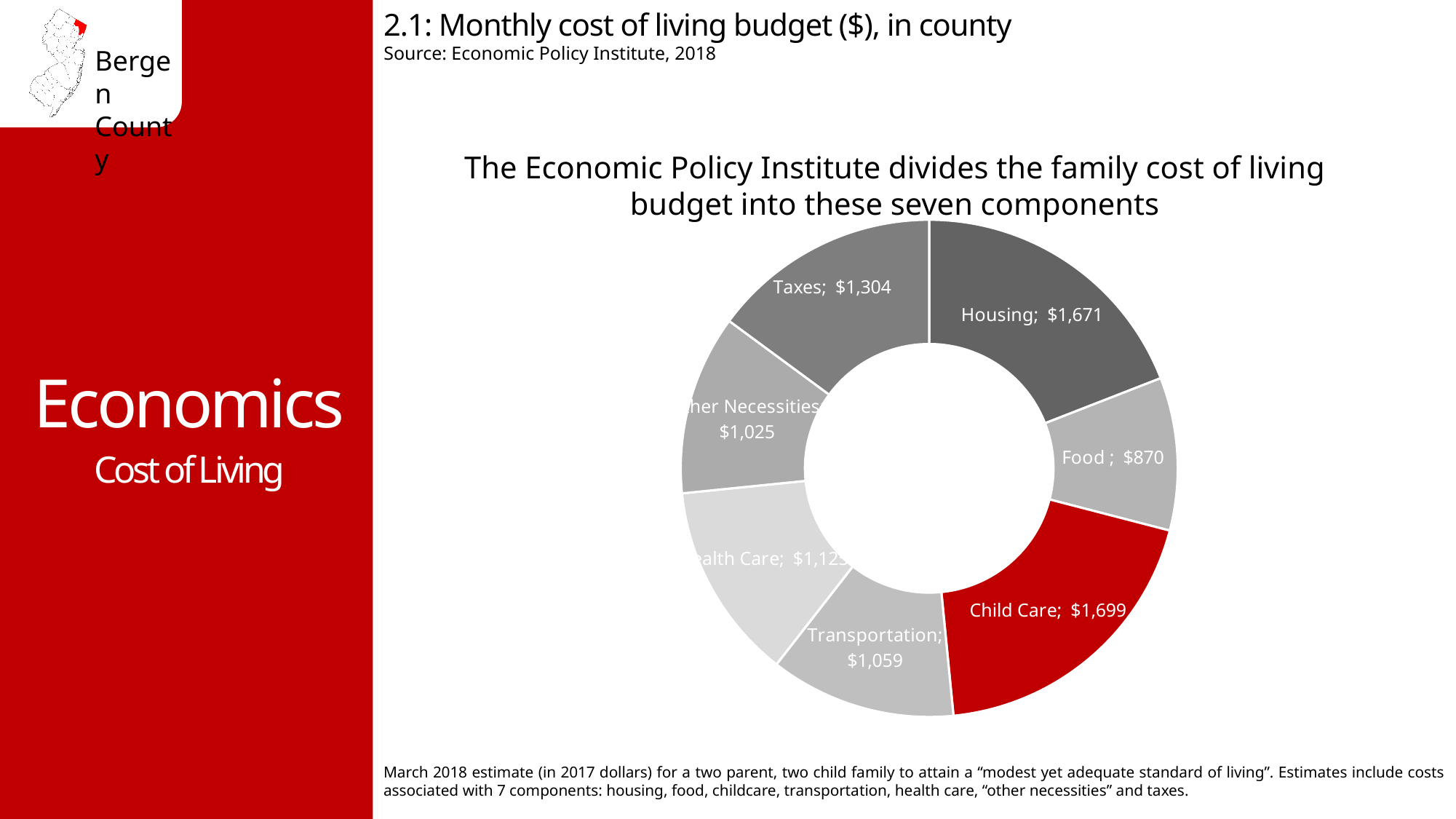
How many components are shown on the chart? 7 Which component has the lowest monthly cost on the chart? Food How much more is the monthly cost for Housing than for Food? $801 What is the monthly cost for Food shown on the chart? $870 What is the monthly cost for Housing shown on the chart? $1,671 Which component is shown in red on the chart? Child Care What is the monthly cost for Child Care shown on the chart? $1,699 What is the monthly cost for Taxes shown on the chart? $1,304 What is the monthly cost for Other Necessities shown on the chart? $1,025 Which is larger, the monthly cost for Taxes or for Transportation? Taxes Which component has the highest monthly cost on the chart? Child Care What is the monthly cost for Transportation shown on the chart? $1,059